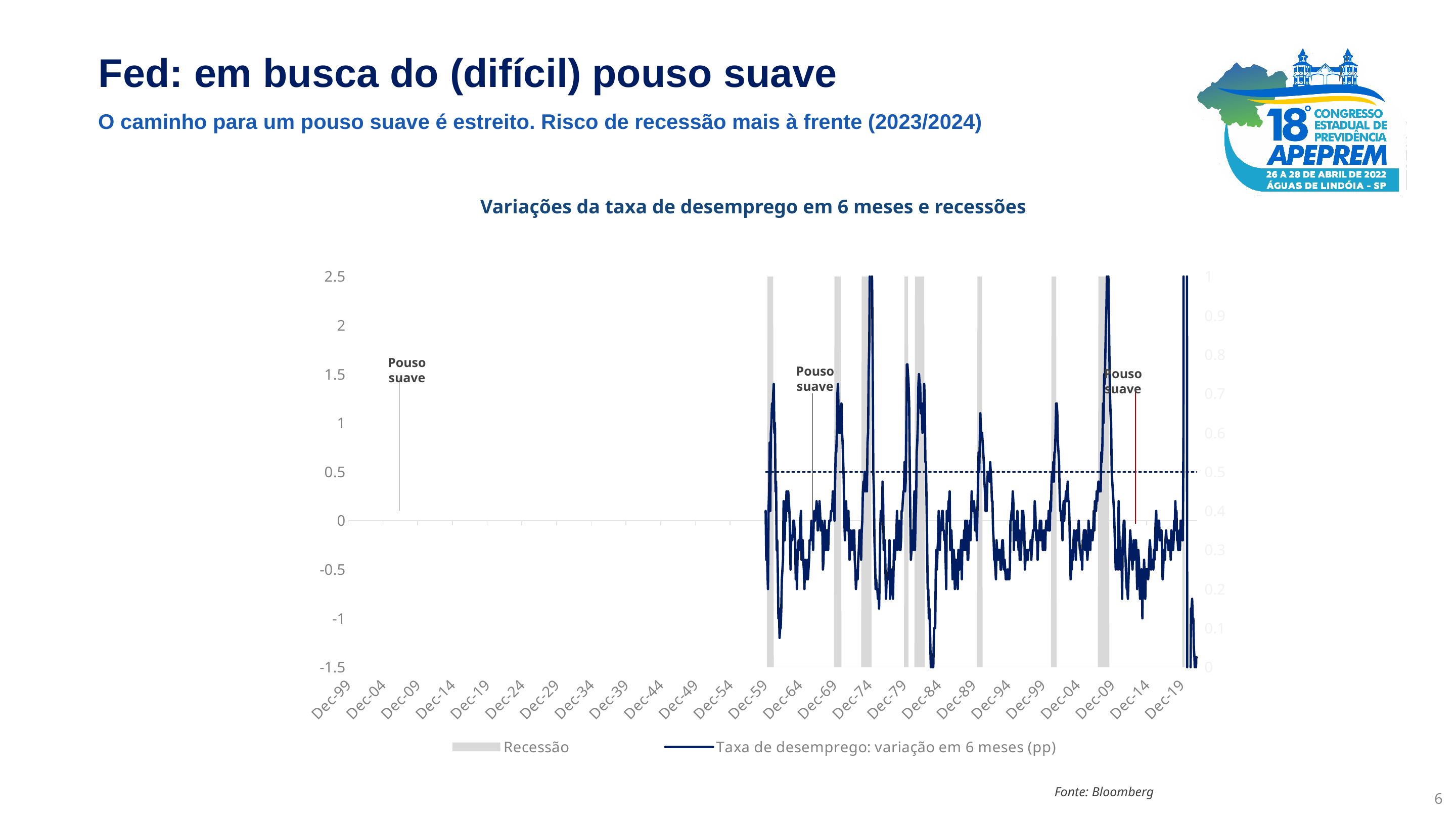
What are the two legend entries of the chart? Recessão; Taxa de desemprego: variação em 6 meses (pp) Is the peak of the unemployment-change line around Dec-89 greater or less than 1.5? less What kind of chart is shown on the slide? line chart At what level on the left axis is the dashed horizontal reference line drawn? 0.5 How many grey recession bands are shaded on the chart? 9 What is the title of the chart? Variações da taxa de desemprego em 6 meses e recessões How many series does the legend list? 2 How many 'Pouso suave' annotations are marked on the chart? 3 Is the peak of the unemployment-change line around Dec-79 greater or less than 1? greater What is the maximum value shown on the left vertical axis? 2.5 Is the peak of the unemployment-change line around Dec-09 greater or less than 1.5? greater